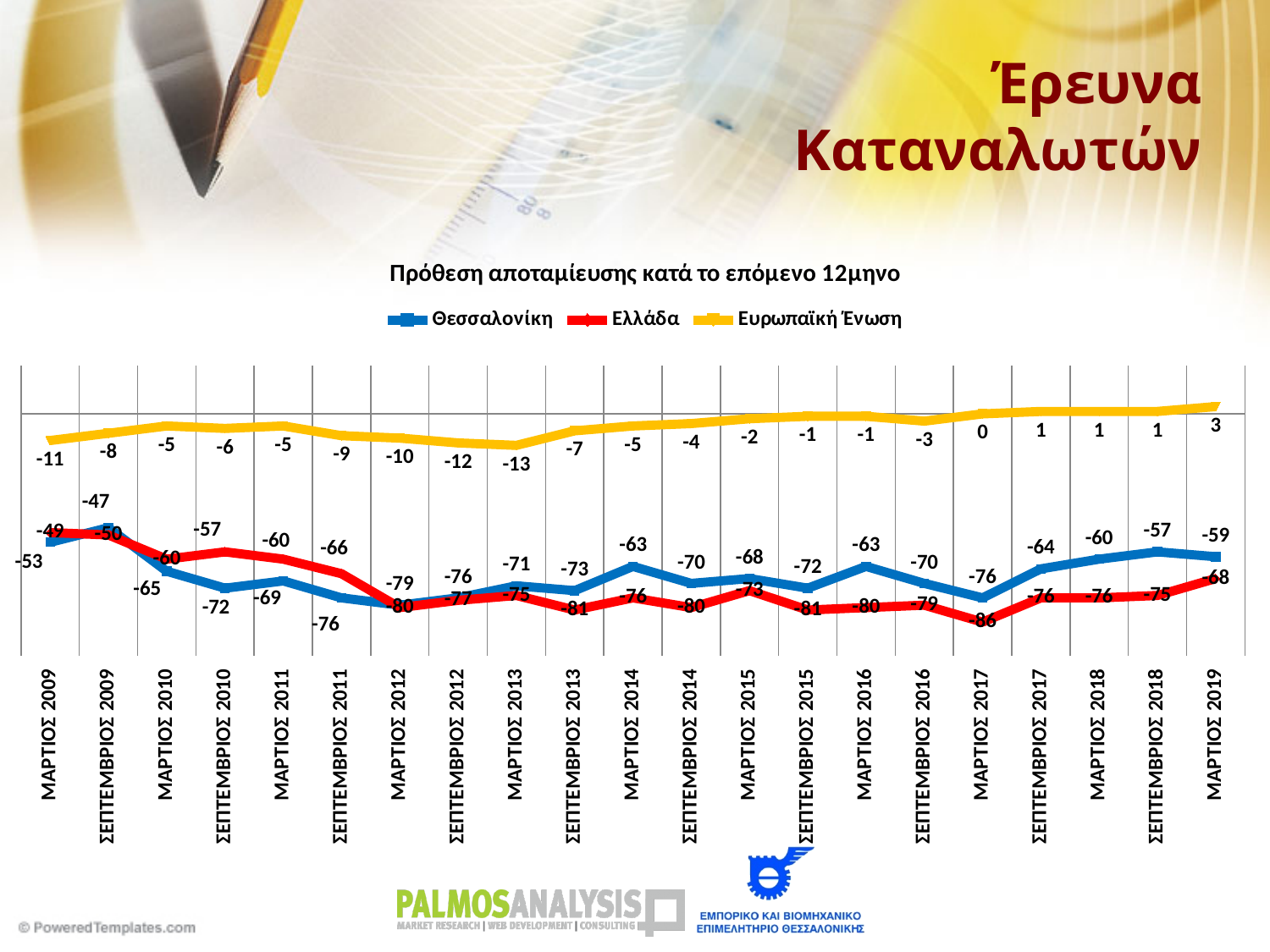
What is the value for Ελλάδα in ΜΑΡΤΙΟΣ 2017? -86 How many series does the legend list? 3 In ΜΑΡΤΙΟΣ 2016, which is higher: the value for Θεσσαλονίκη or for Ελλάδα? Θεσσαλονίκη What is the value for Ευρωπαϊκή Ένωση in ΜΑΡΤΙΟΣ 2013? -13 What is the difference between the Θεσσαλονίκη and Ελλάδα values in ΜΑΡΤΙΟΣ 2019? 9 In which period does the Ελλάδα series reach its lowest value? ΜΑΡΤΙΟΣ 2017 What is the value for Θεσσαλονίκη in ΣΕΠΤΕΜΒΡΙΟΣ 2018? -57 What is the title of the chart? Πρόθεση αποταμίευσης κατά το επόμενο 12μηνο In which period does the Ευρωπαϊκή Ένωση series reach its highest value? ΜΑΡΤΙΟΣ 2019 What kind of chart is shown on the slide? line chart What is the value for Ευρωπαϊκή Ένωση in ΜΑΡΤΙΟΣ 2019? 3 How many time points are plotted along the x axis? 21